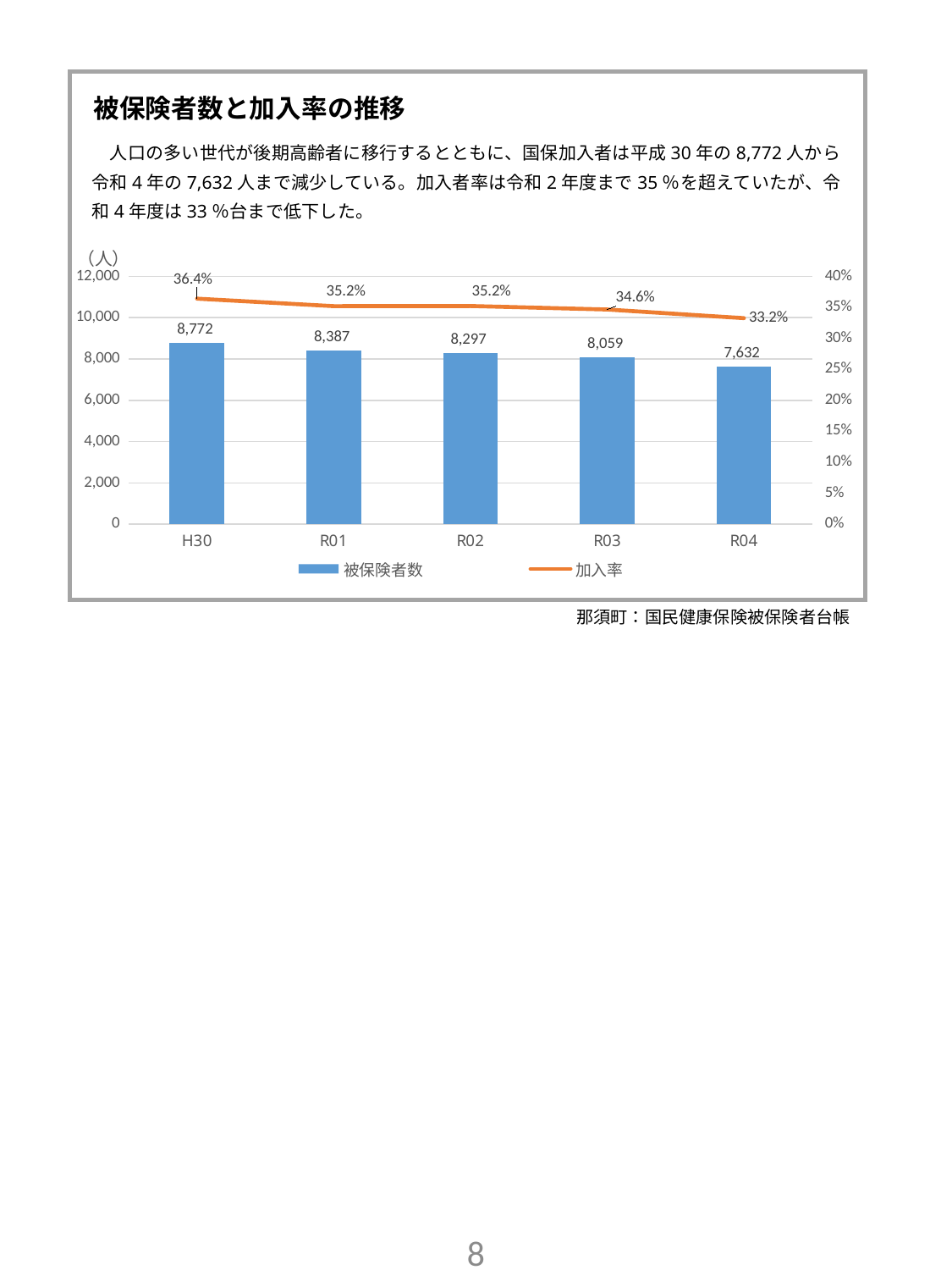
What is the title of the chart? 被保険者数と加入率の推移 Which year has the highest 被保険者数? H30 Which year has the lowest 加入率? R04 Does 加入率 rise or fall from H30 to R04? fall Which is larger, the 被保険者数 for R01 or for R03? R01 What is the value of 被保険者数 for H30? 8,772 How many series does the legend list? 2 What is the value of 加入率 for R04? 33.2% What is the difference in 被保険者数 between H30 and R04? 1,140 What kind of chart is used for 被保険者数? bar chart What is the value of 被保険者数 for R02? 8,297 How many years are shown on the x axis? 5